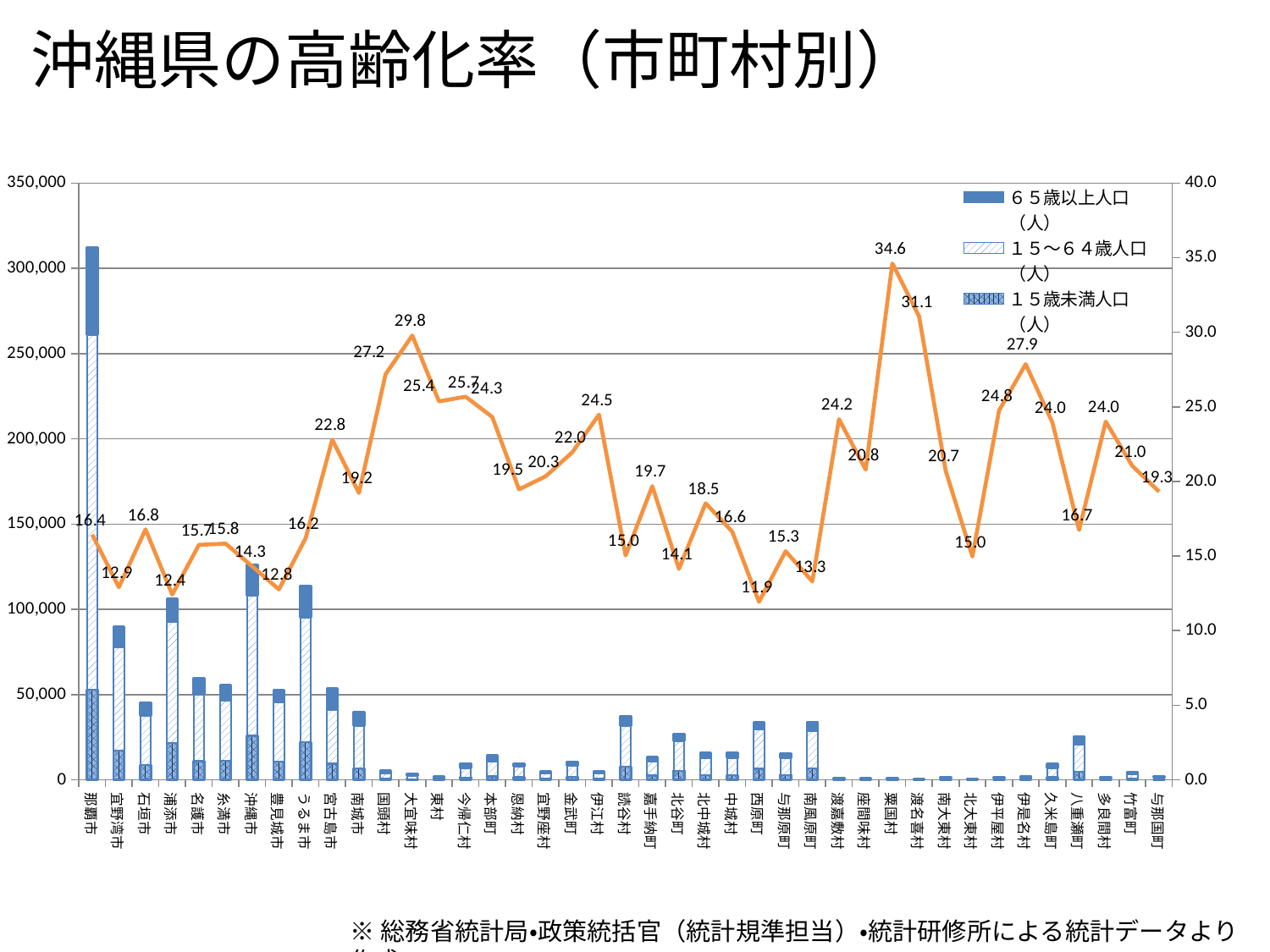
What is the aging rate (line value) shown for 粟国村? 34.6 What is the aging rate (line value) shown for 大宜味村? 29.8 Which municipality has the highest aging rate on the line? 粟国村 How many series does the legend list? 3 Which has a higher aging rate, 国頭村 or 宮古島市? 国頭村 How many municipalities are shown on the x axis? 41 Is the total population bar for 那覇市 greater or less than 300,000? greater Is the total population bar for 宜野湾市 greater or less than 100,000? less Which municipality has the lowest aging rate on the line? 西原町 What is the title of the slide? 沖縄県の高齢化率（市町村別） What is the difference between the aging rates of 粟国村 and 渡名喜村? 3.5 What is the aging rate (line value) shown for 那覇市? 16.4